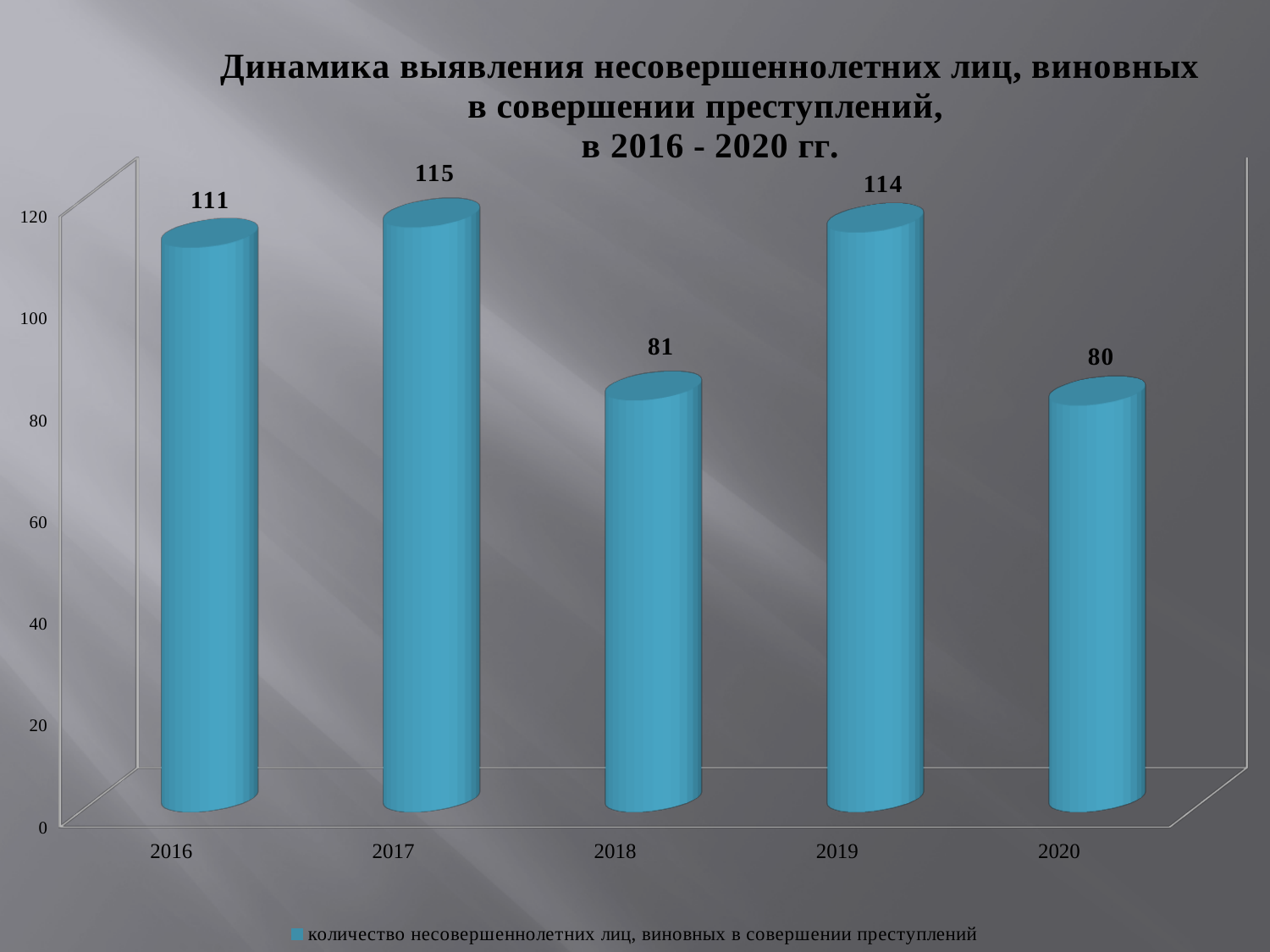
What is the difference between the values for 2019 and 2020? 34 What is the value for 2020? 80 What kind of chart is this? bar chart Is the value for 2018 greater or less than 100? less Which year has the lowest value? 2020 What is the difference between the values for 2017 and 2018? 34 Which is larger, the value for 2016 or the value for 2019? 2019 How many years are shown on the x axis? 5 What is the legend entry for the series? количество несовершеннолетних лиц, виновных в совершении преступлений What is the value for 2018? 81 What is the value for 2016? 111 Which year has the highest value? 2017